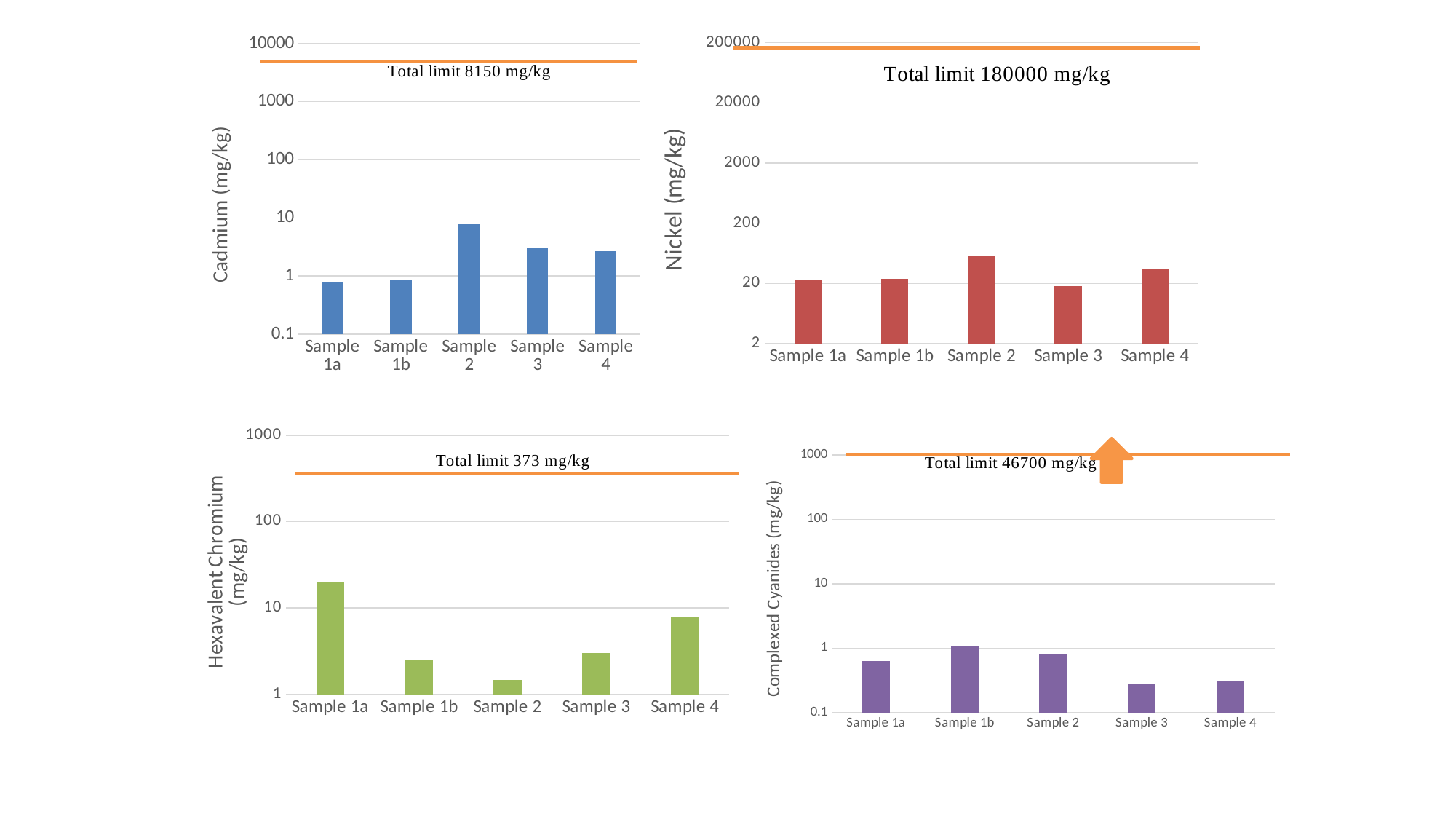
In the Nickel chart, which sample has the highest value? Sample 2 In the Complexed Cyanides chart, which sample has the highest value? Sample 1b In the Complexed Cyanides chart, is the value for Sample 3 greater or less than 1? less In the Hexavalent Chromium chart, which sample has the highest value? Sample 1a What total limit is stated on the Hexavalent Chromium chart? 373 mg/kg In the Cadmium chart, is the value for Sample 2 greater or less than 1? greater In the Nickel chart, is the value for Sample 2 greater or less than 20? greater How many samples are shown on the x axis of the Nickel chart? 5 In the Hexavalent Chromium chart, which sample has the lowest value? Sample 2